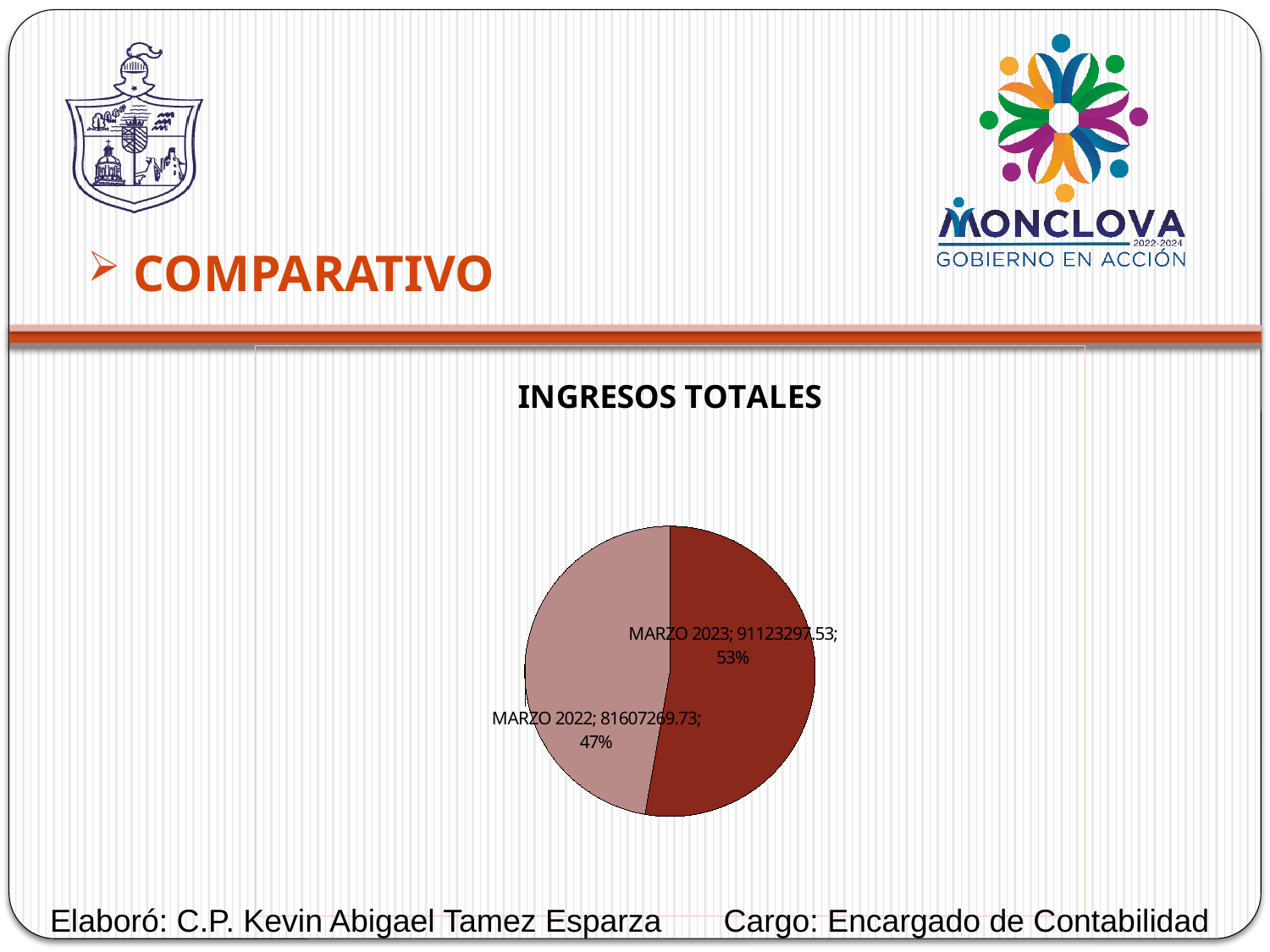
What percentage share of the pie does MARZO 2023 represent? 53% What percentage share of the pie does MARZO 2022 represent? 47% What is the title of the chart on the slide? INGRESOS TOTALES What is the value shown for MARZO 2022 in the pie chart? 81607269.73 Which slice of the pie chart is the smallest? MARZO 2022 How many slices does the INGRESOS TOTALES pie chart have? 2 What is the difference between the MARZO 2023 value and the MARZO 2022 value? 9516027.80 Which slice of the pie chart is the largest? MARZO 2023 What type of chart is shown under the title INGRESOS TOTALES? Pie chart What is the total of the two values shown in the pie chart? 172730567.26 Which is larger, the value for MARZO 2023 or the value for MARZO 2022? MARZO 2023 What is the value shown for MARZO 2023 in the pie chart? 91123297.53